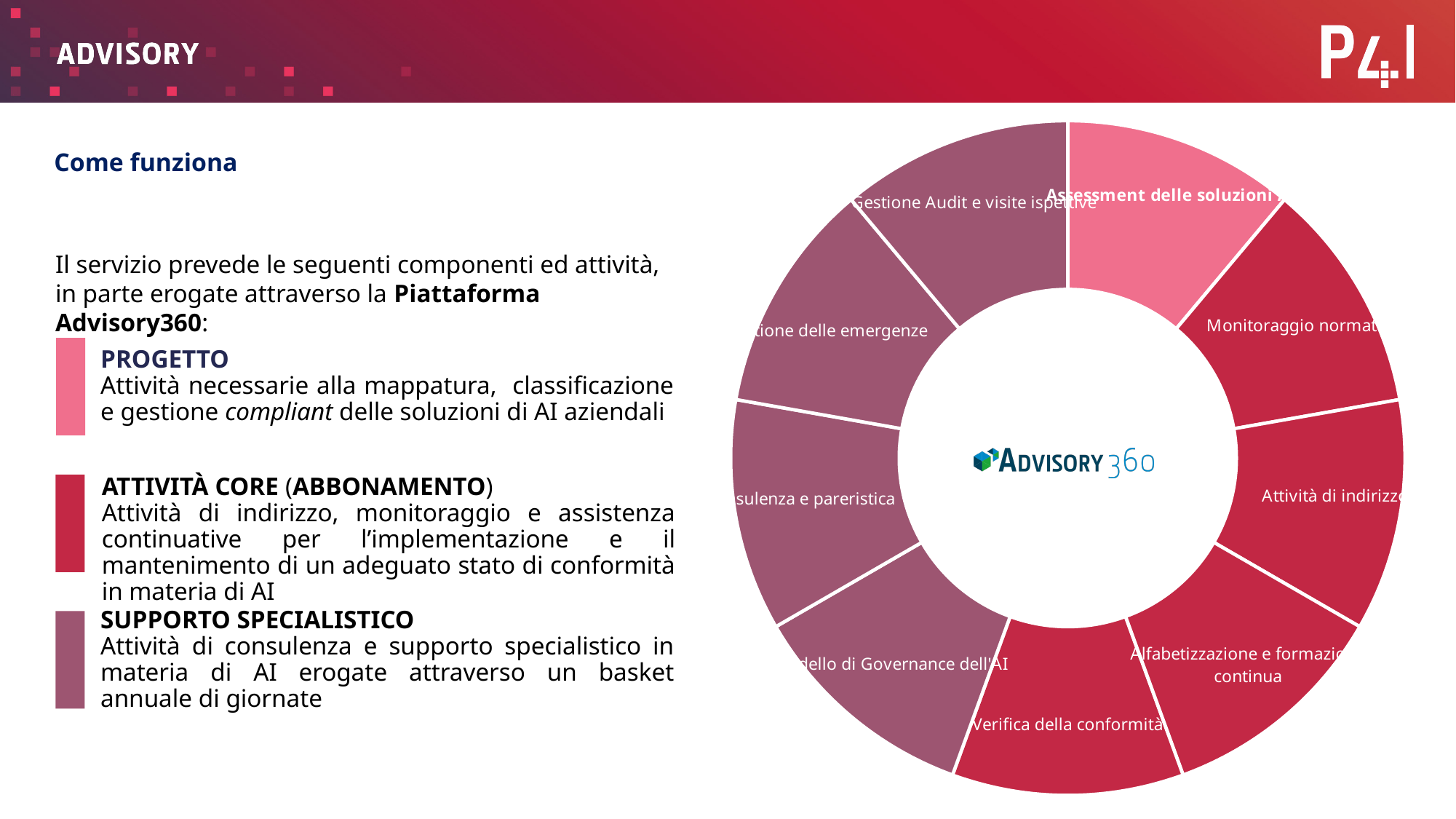
Does the doughnut chart display a legend? No Which segment label appears at the top left of the doughnut chart, next to 'Assessment delle soluzioni AI'? Gestione Audit e visite ispettive How many segments does the doughnut chart have? 9 Which segment of the doughnut chart is coloured light pink? Assessment delle soluzioni AI Which segment label sits at the bottom of the doughnut chart, between 'Modello di Governance dell'AI' and 'Alfabetizzazione e formazione continua'? Verifica della conformità How many segments of the doughnut chart are shown in the mauve (purple-red) colour? 4 What text appears in the centre of the doughnut chart? Advisory360 What kind of chart is shown on the right side of the slide? Doughnut (pie) chart How many segments of the doughnut chart are shown in the light pink colour? 1